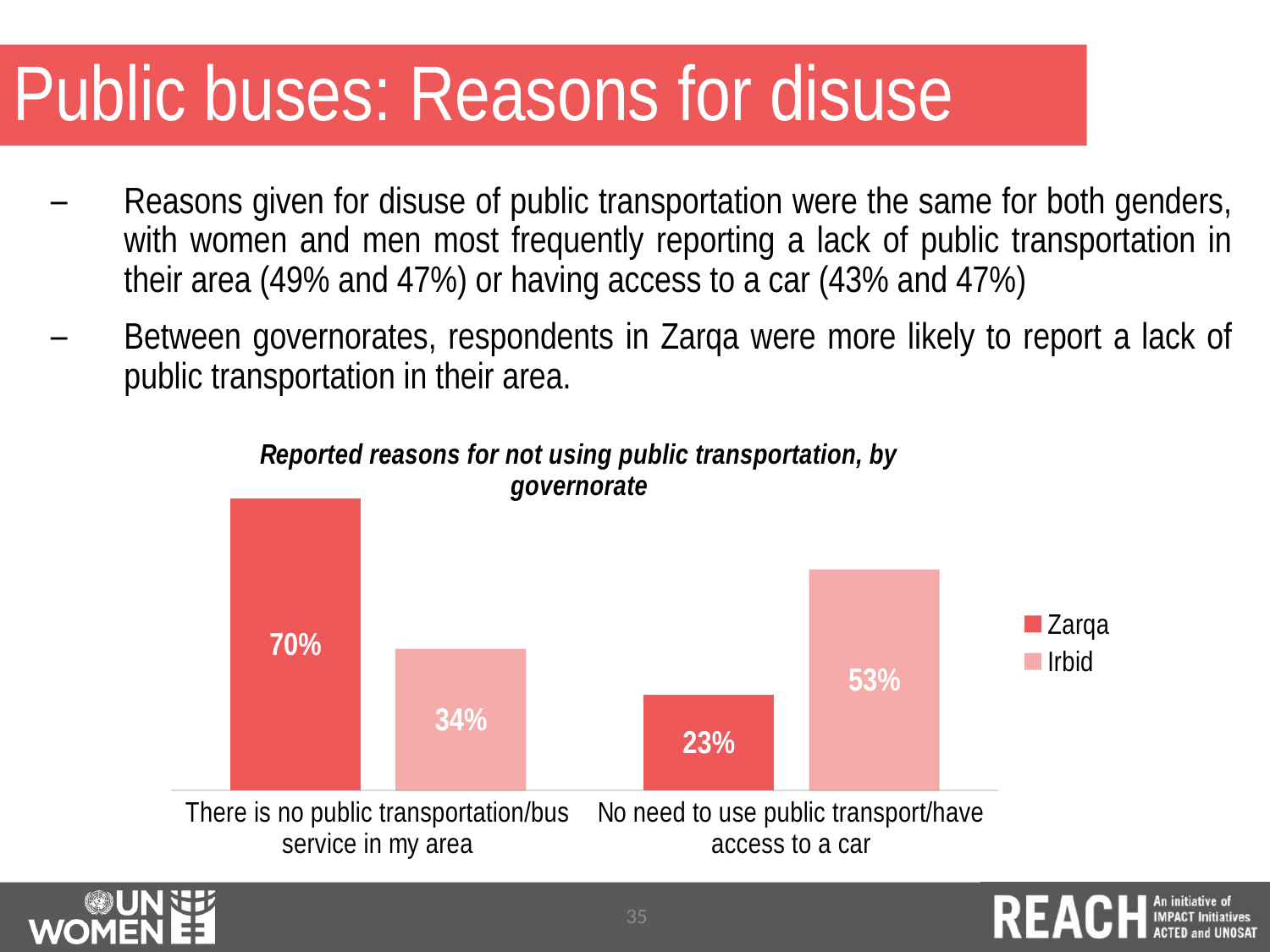
Which bar in the chart has the lowest value? Zarqa, No need to use public transport/have access to a car (23%) What percentage of Zarqa respondents reported there is no public transportation/bus service in their area? 70% What is the difference between the Zarqa and Irbid values for 'There is no public transportation/bus service in my area'? 36% Which governorate has the higher value for 'There is no public transportation/bus service in my area'? Zarqa What percentage of Zarqa respondents reported no need to use public transport/have access to a car? 23% What percentage of Irbid respondents reported no need to use public transport/have access to a car? 53% What percentage of Irbid respondents reported there is no public transportation/bus service in their area? 34% Which governorate has the higher value for 'No need to use public transport/have access to a car'? Irbid What type of chart is shown on the slide? Bar chart What is the difference between the Irbid and Zarqa values for 'No need to use public transport/have access to a car'? 30% How many series does the legend list? 2 How many reason categories are shown on the x axis? 2